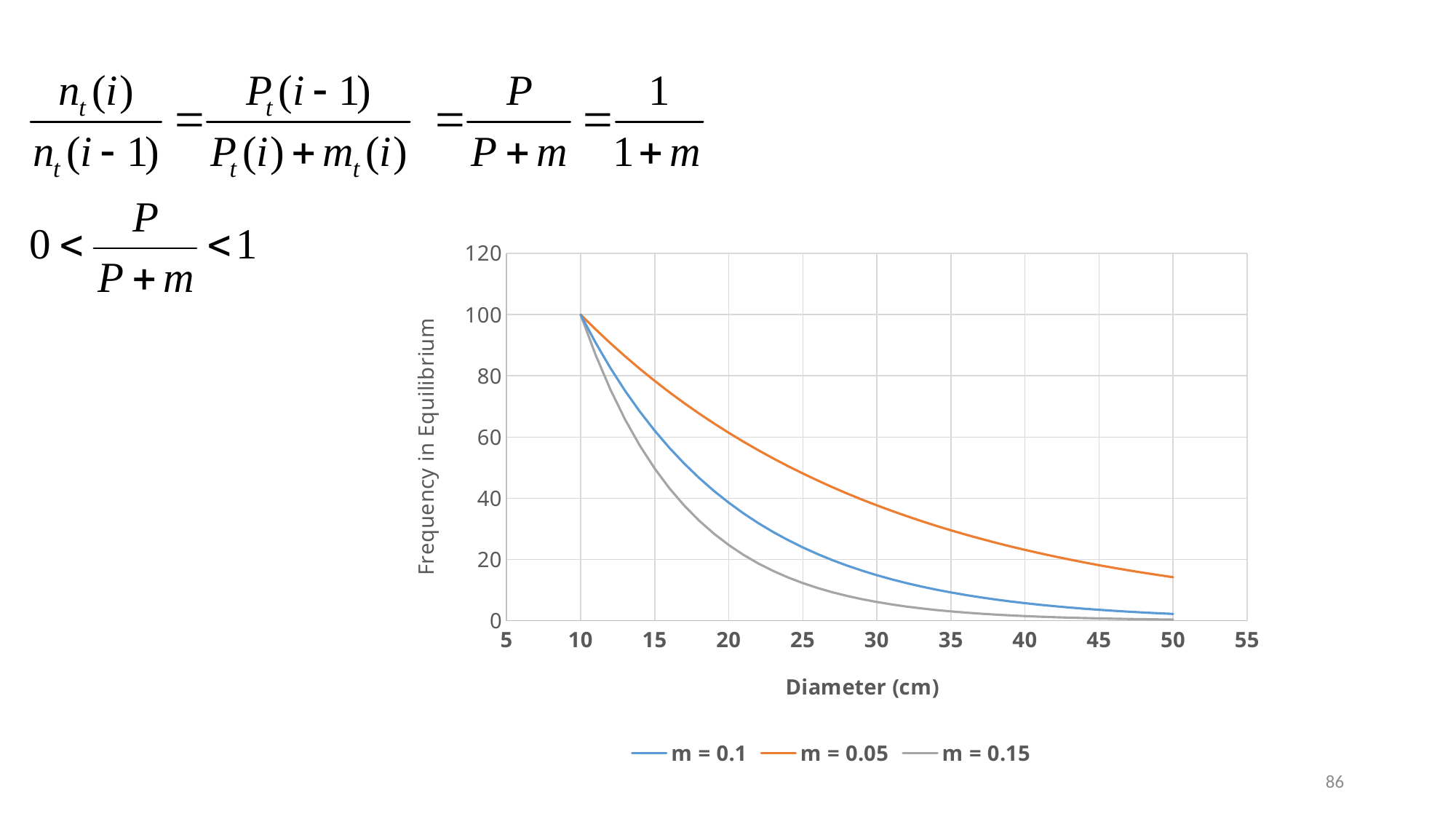
Which series has the lowest Frequency in Equilibrium at a diameter of 25 cm? m = 0.15 Is the value for the m = 0.1 series at a diameter of 15 cm greater or less than 40? greater How many series does the legend of the chart list? 3 Is the value for the m = 0.1 series at a diameter of 50 cm greater or less than 20? less What is the title of the x axis of the chart? Diameter (cm) What is the Frequency in Equilibrium for the m = 0.05 series at a diameter of 10 cm? 100 Which series has the highest Frequency in Equilibrium at a diameter of 50 cm? m = 0.05 At a diameter of 30 cm, which series has the higher value, m = 0.05 or m = 0.15? m = 0.05 What type of chart is shown on the slide? line chart Do the values of the m = 0.1 series rise or fall as diameter increases? fall Is the value for the m = 0.15 series at a diameter of 20 cm greater or less than 40? less